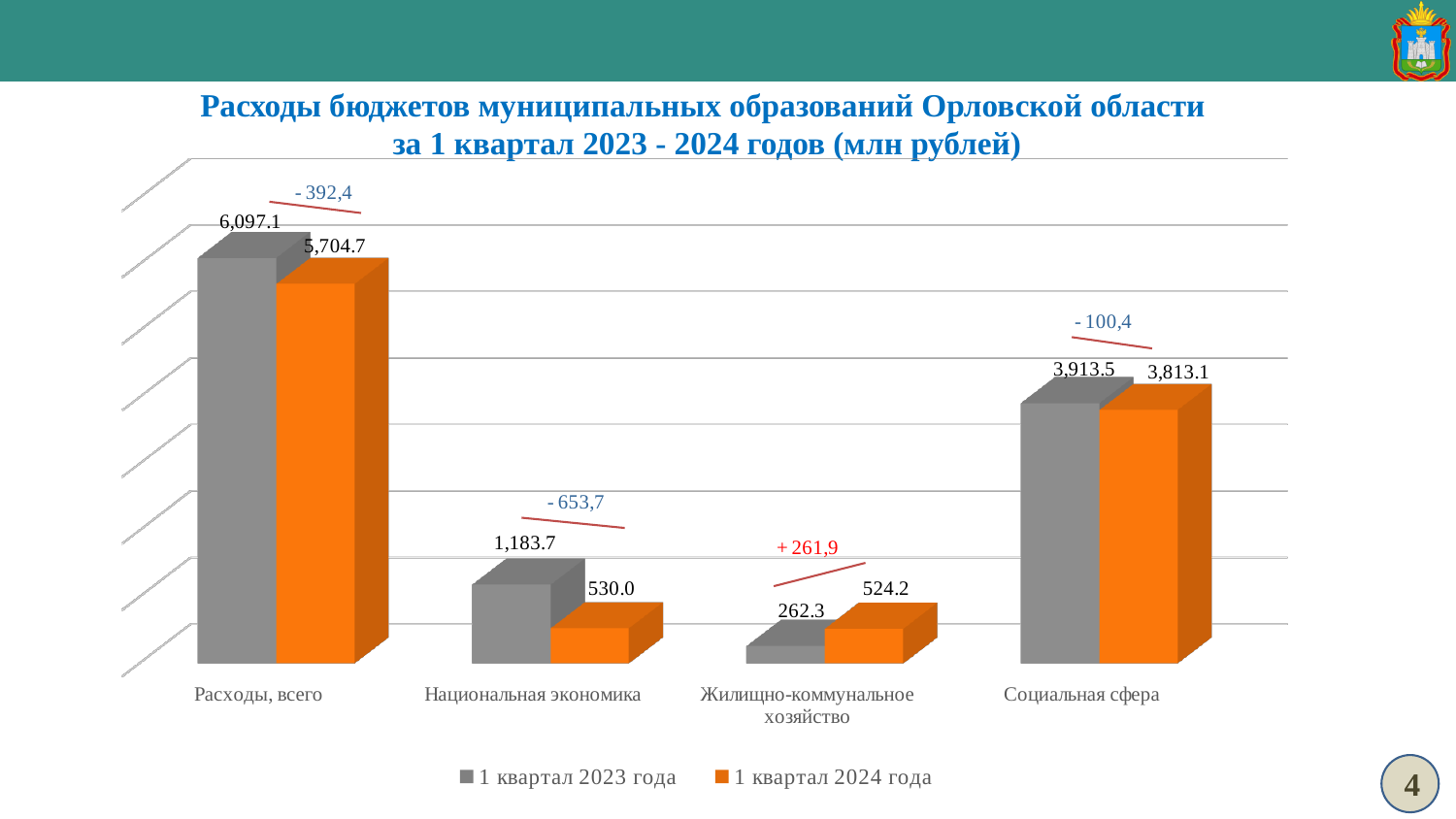
Which category has the highest value in 1 квартал 2024 года? Расходы, всего What is the value for Социальная сфера in 1 квартал 2024 года? 3,813.1 How many series does the legend list? 2 What is the value for Национальная экономика in 1 квартал 2024 года? 530.0 What is the value for Жилищно-коммунальное хозяйство in 1 квартал 2023 года? 262.3 What is the value for Расходы, всего in 1 квартал 2024 года? 5,704.7 For Жилищно-коммунальное хозяйство, which is larger: the 1 квартал 2023 года value or the 1 квартал 2024 года value? 1 квартал 2024 года How many categories are shown on the x axis? 4 Which category has the lowest value in 1 квартал 2023 года? Жилищно-коммунальное хозяйство What is the difference between the 1 квартал 2023 года and 1 квартал 2024 года values for Национальная экономика? 653.7 What is the value for Расходы, всего in 1 квартал 2023 года? 6,097.1 What kind of chart is shown on the slide? Bar chart